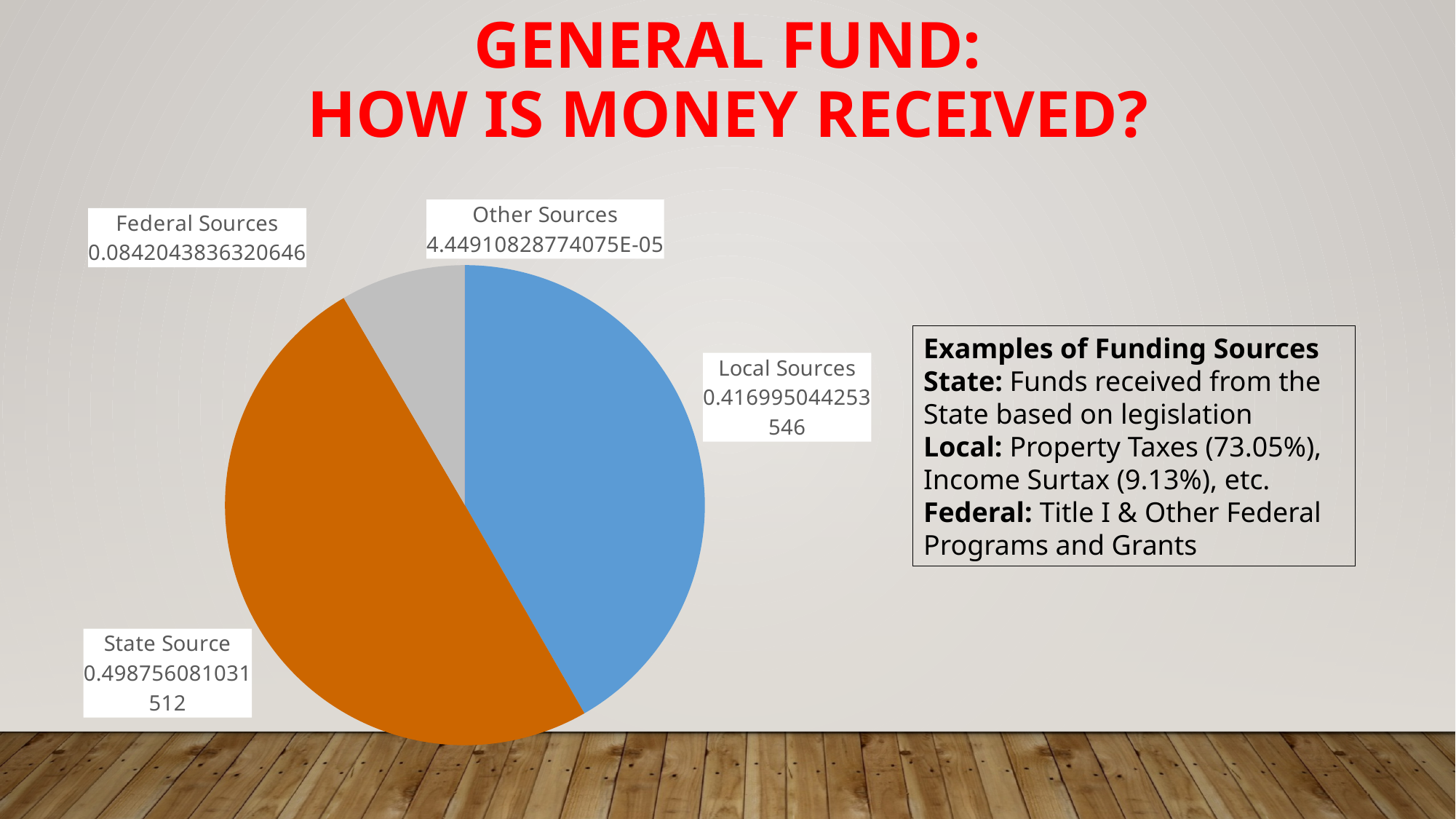
What colour is the State Source slice in the pie chart? Orange What is the difference between the State Source value and the Local Sources value in the pie chart? 0.081761036777966 Which is larger in the pie chart, Federal Sources or Local Sources? Local Sources What is the value shown for State Source in the pie chart? 0.498756081031512 What is the value shown for Federal Sources in the pie chart? 0.0842043836320646 Which source has the smallest slice of the pie chart? Other Sources How many slices does the pie chart have? 4 What kind of chart is shown on the slide? Pie chart What is the value shown for Other Sources in the pie chart? 4.44910828774075E-05 Which is larger in the pie chart, State Source or Local Sources? State Source Which source has the largest slice of the pie chart? State Source What is the value shown for Local Sources in the pie chart? 0.416995044253546